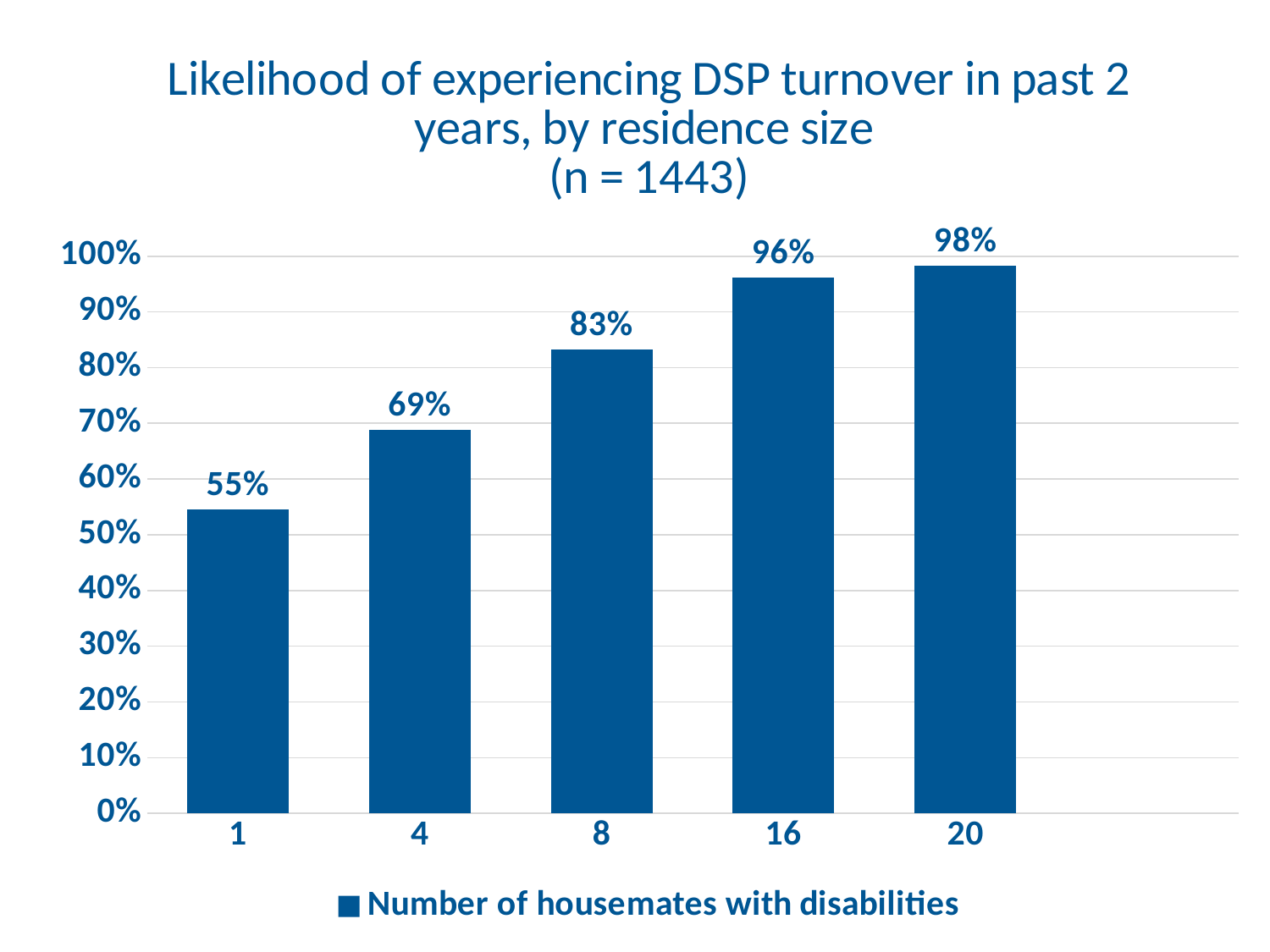
Which residence size has the highest likelihood of DSP turnover? 20 Do the values rise or fall as the number of housemates with disabilities increases? Rise Which is larger, the value for 4 housemates or the value for 8 housemates? 8 housemates Which residence size has the lowest likelihood of DSP turnover? 1 What is the difference between the values for 20 and 8 housemates with disabilities? 15% What kind of chart is shown on the slide? Bar chart How many residence size categories are shown on the x axis? 5 Is the value for 4 housemates with disabilities greater or less than 60%? greater What is the value shown for 16 housemates with disabilities? 96% What is the value shown for 8 housemates with disabilities? 83% What is the difference between the values for 4 and 1 housemates with disabilities? 14% What is the likelihood of experiencing DSP turnover for residences with 1 housemate with disabilities? 55%